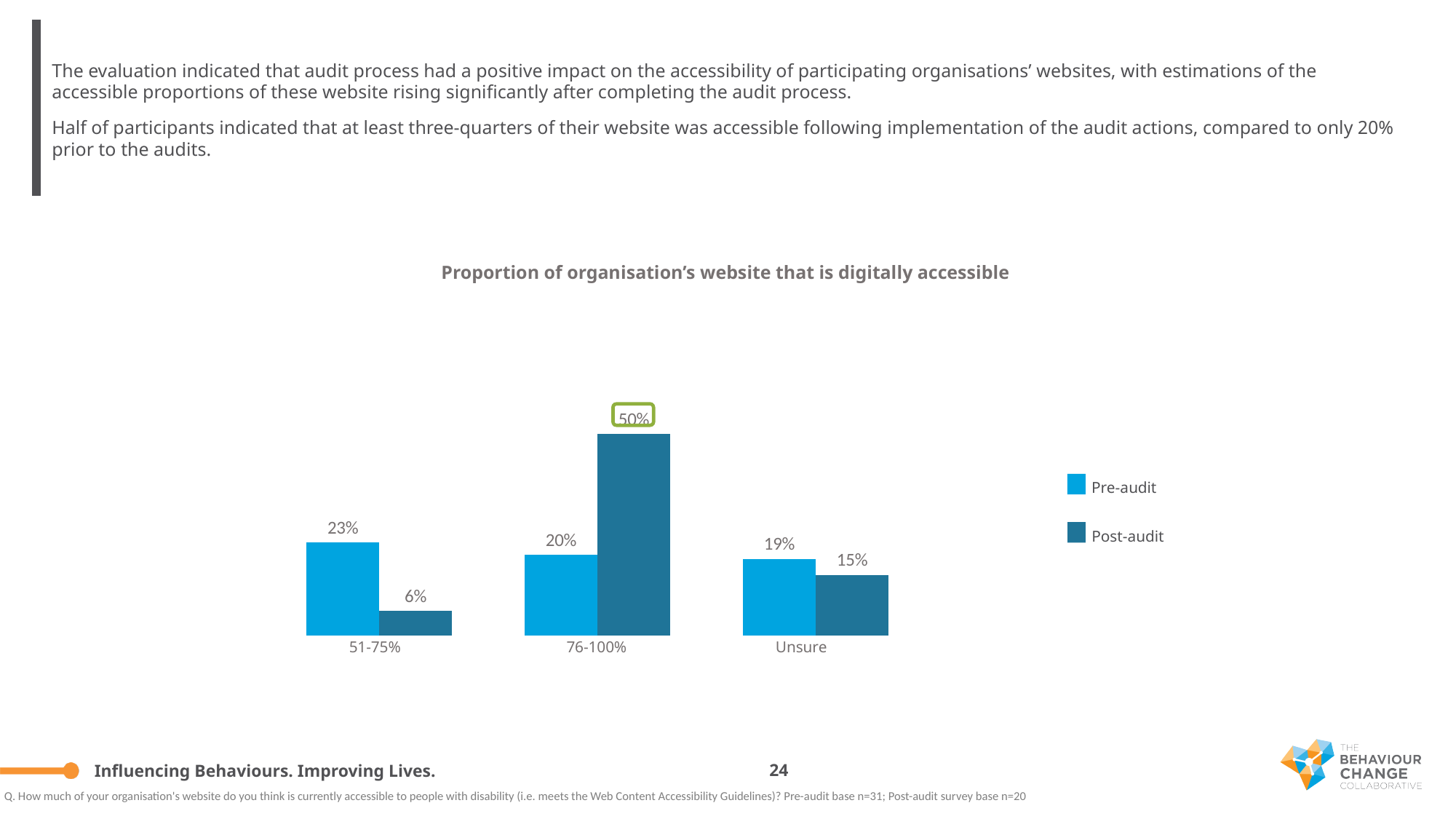
How many categories are shown on the x axis? 3 Which category has the lowest Post-audit value? 51-75% How many series does the legend list? 2 What is the Pre-audit value for the 51-75% category? 23% Which is larger for the Unsure category, the Pre-audit or Post-audit value? Pre-audit Which category has the highest Pre-audit value? 51-75% What is the Post-audit value for the 76-100% category? 50% What is the difference between the Pre-audit and Post-audit values for the 51-75% category? 17 percentage points What is the Post-audit value for the Unsure category? 15% What type of chart is shown on the slide? Bar chart Which category has the highest Post-audit value? 76-100% What is the difference between the Post-audit and Pre-audit values for the 76-100% category? 30 percentage points